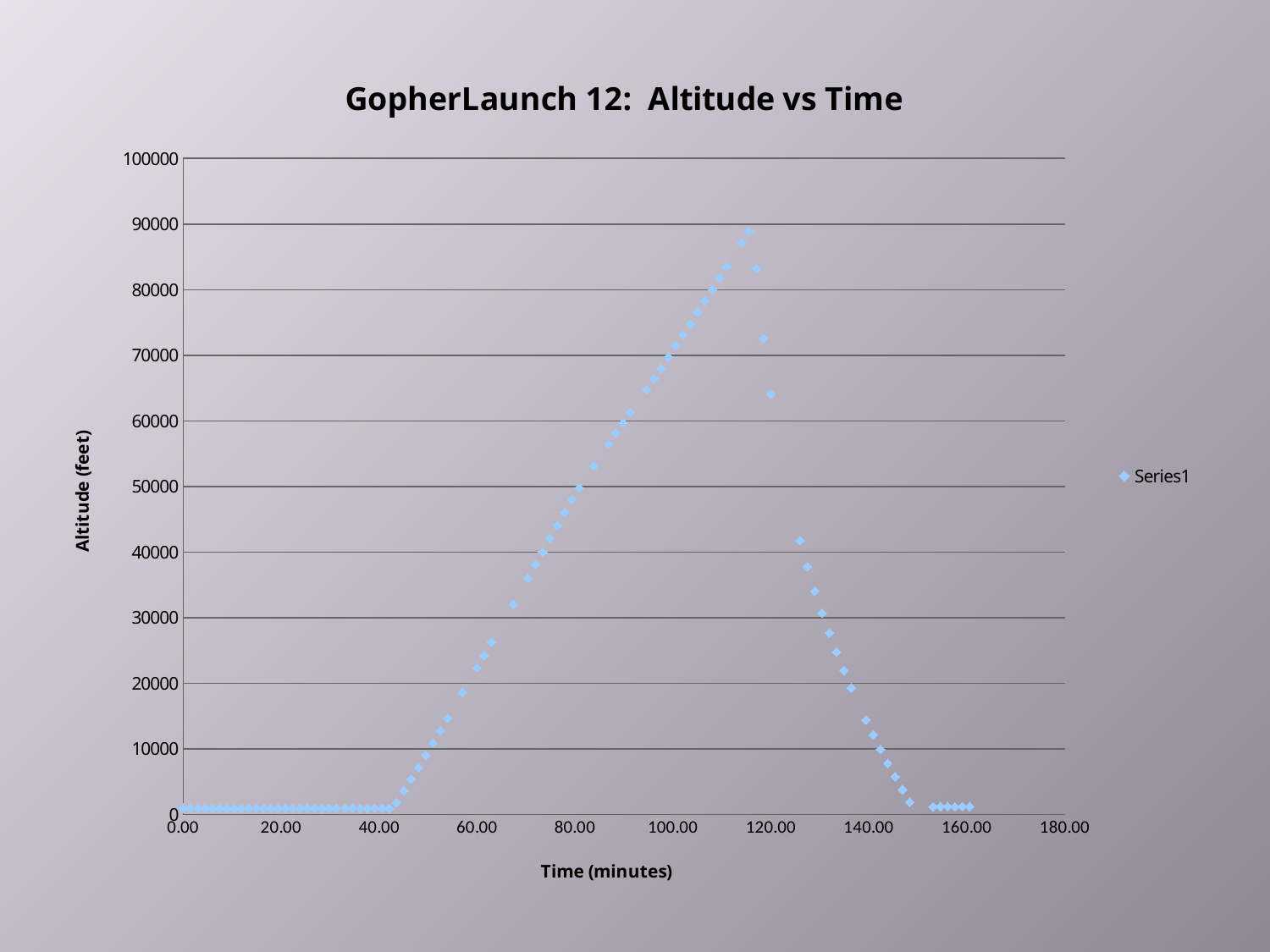
Is the altitude at 110.00 minutes greater or less than 80000? greater How many series does the legend list? 1 Is the altitude at 100.00 minutes greater or less than 60000? greater What is the label on the vertical axis? Altitude (feet) What is the title of the chart? GopherLaunch 12: Altitude vs Time What kind of chart is shown on the slide? Scatter chart Is the altitude at 140.00 minutes greater or less than 10000? greater Does the altitude rise or fall between 60.00 and 100.00 minutes? rise Does the altitude rise or fall between 120.00 and 150.00 minutes? fall Which is larger, the altitude at 80.00 minutes or the altitude at 140.00 minutes? 80.00 minutes